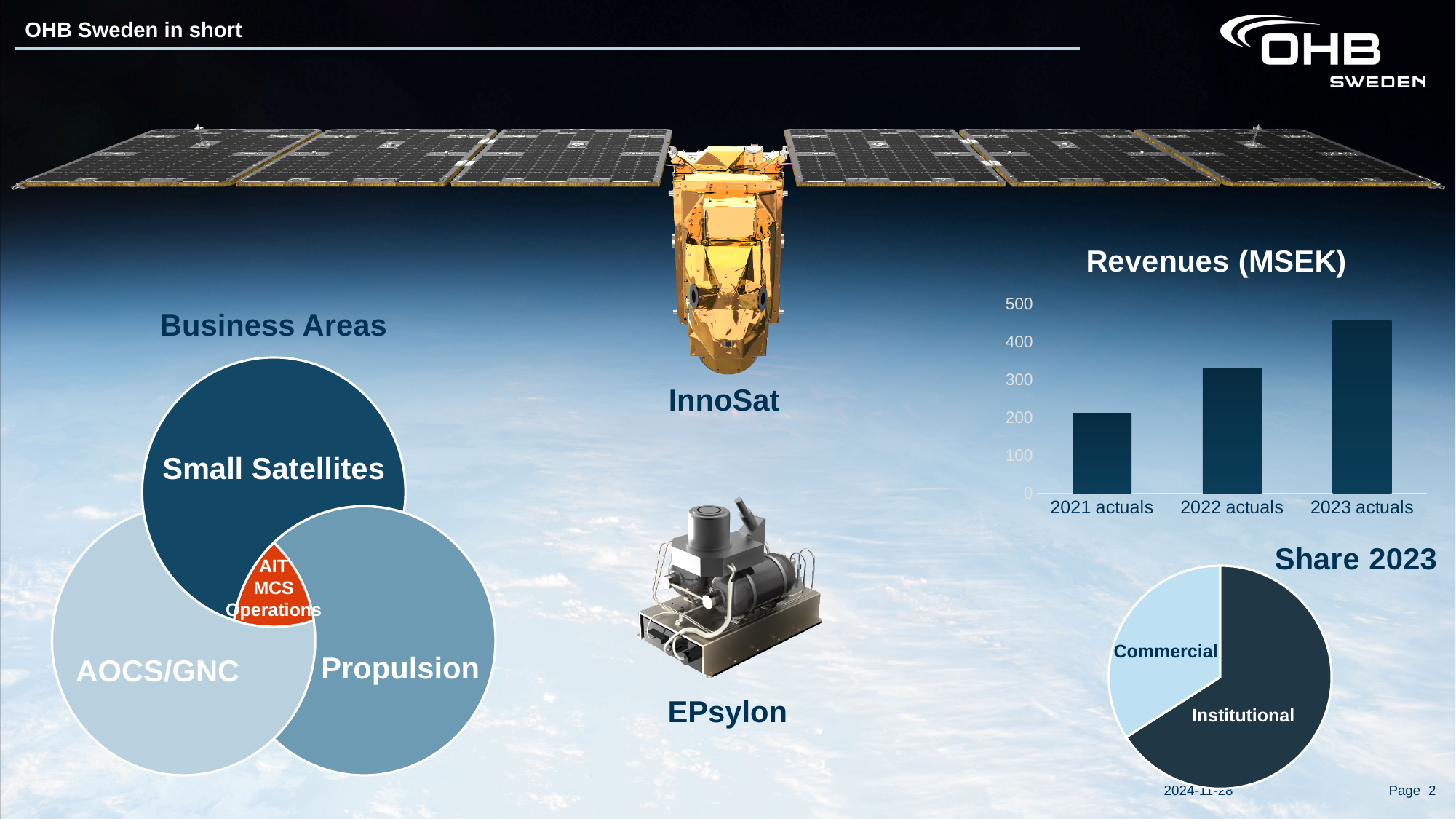
How many slices does the Share 2023 pie chart have? 2 In the Share 2023 pie chart, which slice is larger, Commercial or Institutional? Institutional In the Revenues (MSEK) chart, which year has the highest revenue? 2023 actuals How many bars does the Revenues (MSEK) chart show? 3 What kind of chart is the Share 2023 chart? pie chart In the Revenues (MSEK) chart, is the value for 2023 actuals greater or less than 400? greater In the Revenues (MSEK) chart, is the value for 2021 actuals greater or less than 300? less In the Revenues (MSEK) chart, is the value for 2022 actuals greater or less than 200? greater In the Revenues (MSEK) chart, which year has the lowest revenue? 2021 actuals In the Revenues (MSEK) chart, do revenues rise or fall from 2021 actuals to 2023 actuals? rise What kind of chart is the Revenues (MSEK) chart? bar chart In the Revenues (MSEK) chart, which is larger, 2022 actuals or 2021 actuals? 2022 actuals